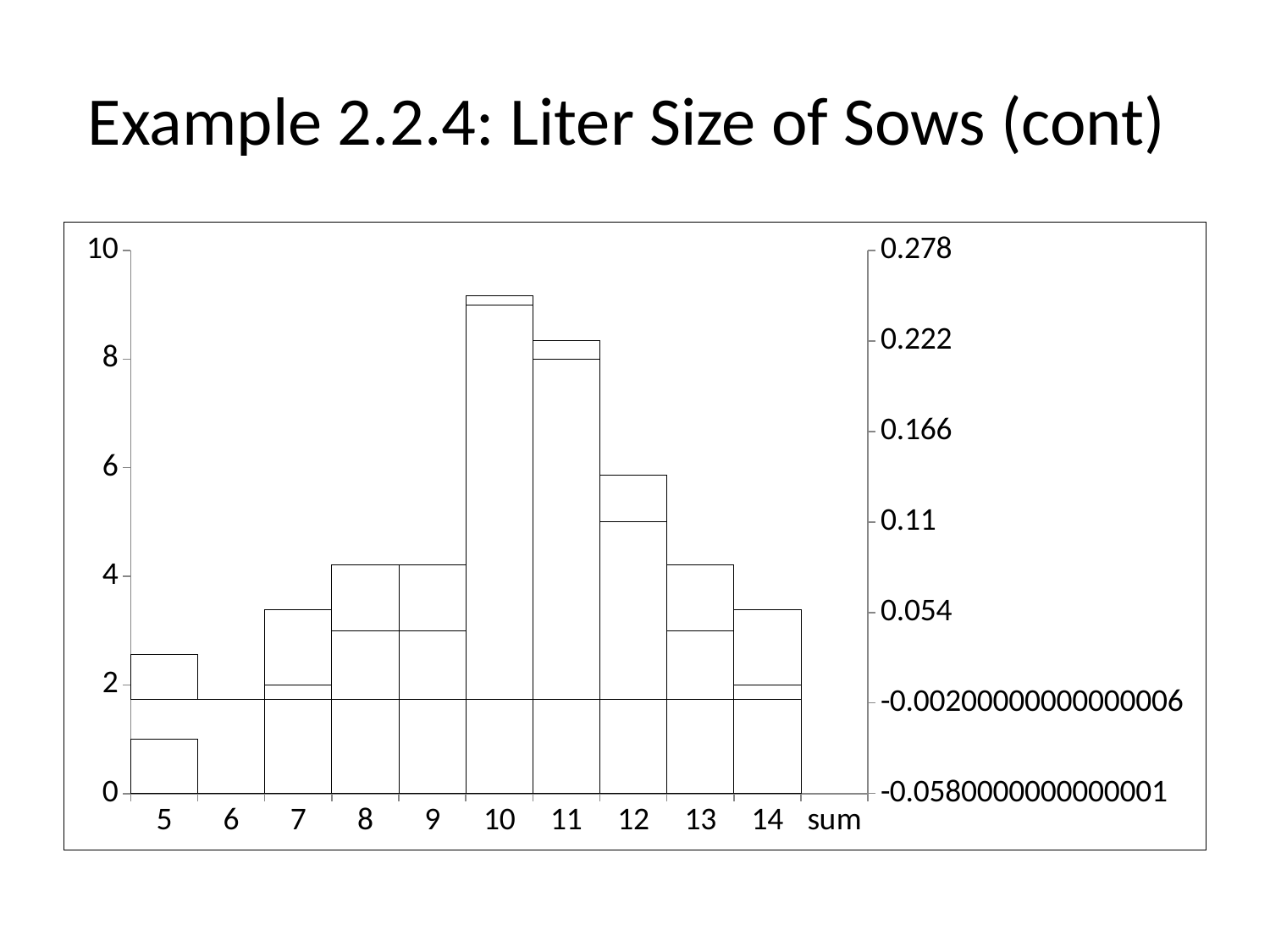
Is the value for category 10 greater or less than 8 on the left axis? greater On the left axis, what is the value of the lower bar for category 14? 2 On the left axis, what is the value of the lower bar for category 11? 8 Is the value for category 5 greater or less than 4 on the left axis? less Which category has the taller bar, 12 or 13? 12 What is the title of the slide? Example 2.2.4: Liter Size of Sows (cont) On the left axis, what is the value of the lower bar for category 7? 2 Which category has no bar (the lowest value)? 6 Which category has the tallest bar? 10 How many categories are labelled along the x axis? 11 What kind of chart is shown on the slide? bar chart Which category has the taller bar, 10 or 11? 10